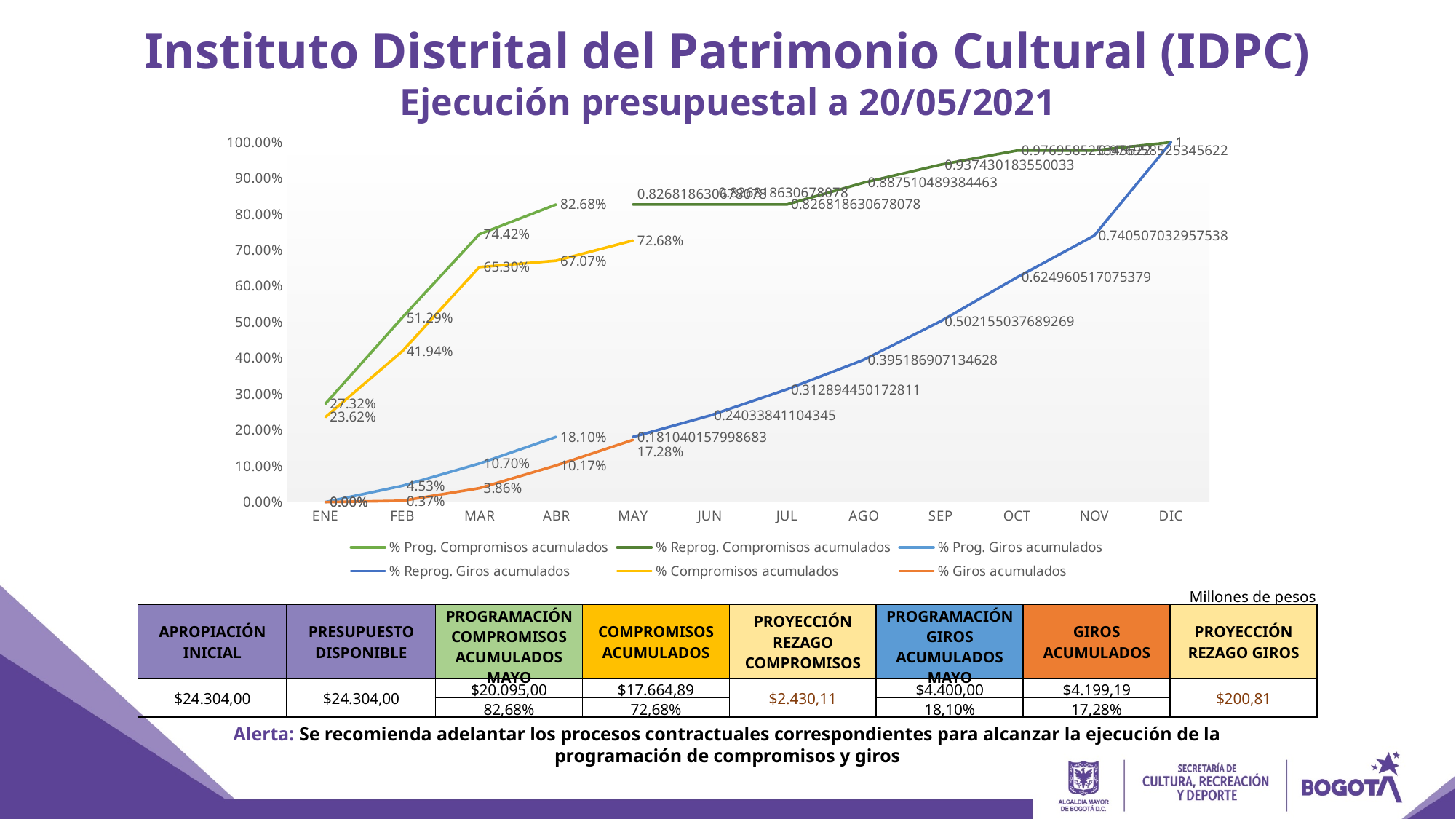
How many series does the chart legend list? 6 What is the value of % Prog. Compromisos acumulados in ABR? 82.68% In ABR, what is the difference between % Prog. Compromisos acumulados and % Compromisos acumulados? 15.61 percentage points What is the value of % Giros acumulados in FEB? 0.37% Does the % Reprog. Giros acumulados line rise or fall from MAY to DIC? Rises What is the value of % Compromisos acumulados in MAY? 72.68% In MAR, which is larger: % Prog. Compromisos acumulados or % Compromisos acumulados? % Prog. Compromisos acumulados What is the value of % Giros acumulados in MAY? 17.28% What is the value of % Prog. Giros acumulados in ABR? 18.10% How many months are shown along the x axis of the chart? 12 In which month does % Compromisos acumulados reach its highest value? MAY What kind of chart is shown on the slide? Line chart